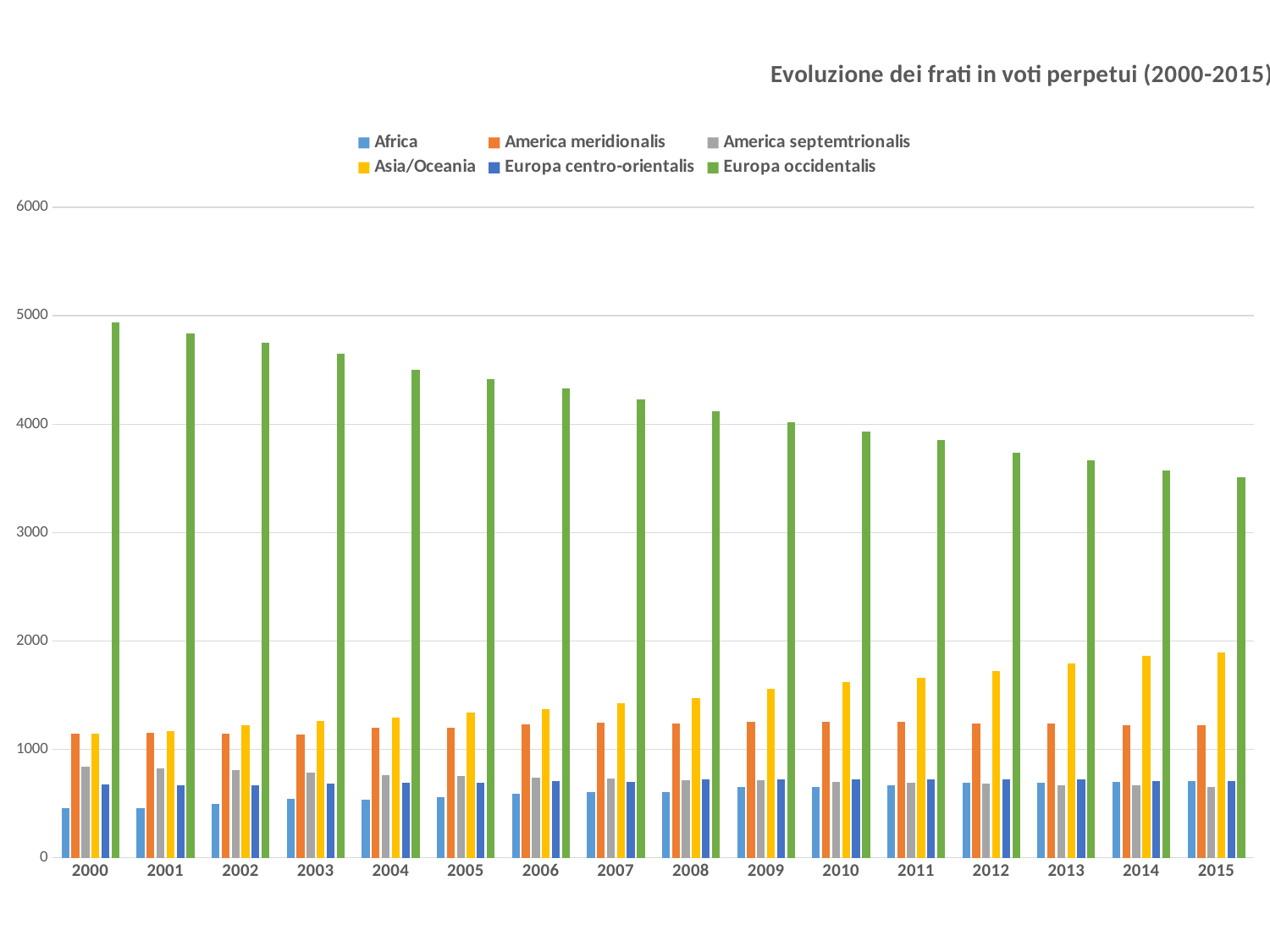
Is the value for Europa occidentalis in 2000 greater or less than 4000? greater Which series has the lowest value in 2000? Africa Do the values for Asia/Oceania rise or fall from 2000 to 2015? Rise What is the title of the chart? Evoluzione dei frati in voti perpetui (2000-2015) Which is larger in 2015, Asia/Oceania or America meridionalis? Asia/Oceania Is the value for Africa in 2000 greater or less than 1000? less Is the value for Europa occidentalis in 2015 greater or less than 4000? less How many years are shown on the x axis? 16 Which series has the highest value in 2000? Europa occidentalis What kind of chart is shown on the slide? Bar chart How many series does the legend list? 6 Do the values for Europa occidentalis rise or fall from 2000 to 2015? Fall